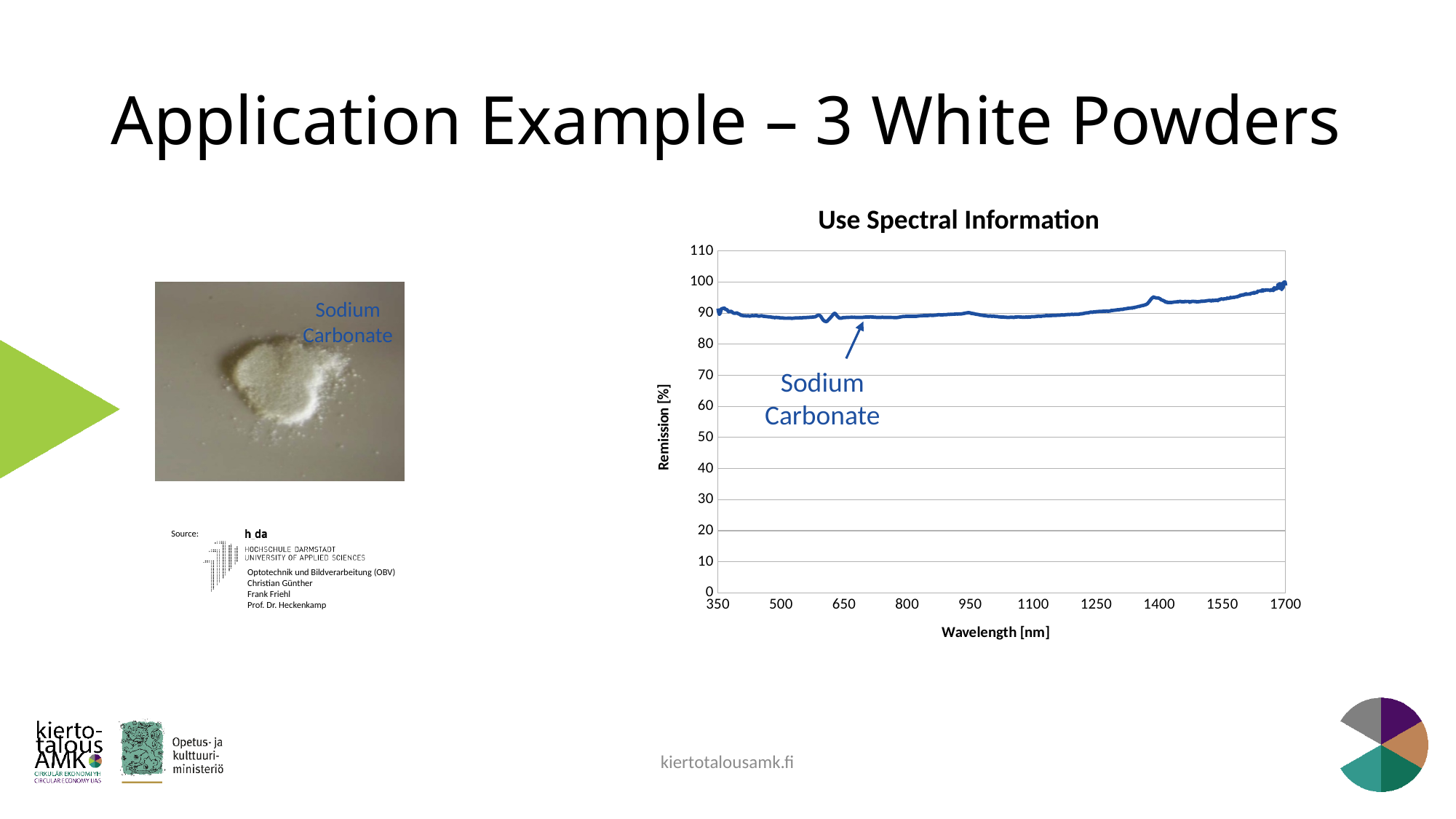
What is the highest wavelength value shown on the x axis of the chart? 1700 Is the remission value for Sodium Carbonate at 1100 nm greater or less than 80? greater What is the highest value shown on the y axis of the chart? 110 Is the remission value for Sodium Carbonate at 500 nm greater or less than 100? less How many data series are plotted in the chart? 1 Does the remission of Sodium Carbonate overall rise or fall from 350 nm to 1700 nm? rise What is the title of the chart on the slide? Use Spectral Information Which wavelength has the higher remission for Sodium Carbonate, 1100 nm or 1700 nm? 1700 nm What kind of chart is shown under the title "Use Spectral Information"? line chart What is the label of the x axis of the chart? Wavelength [nm] Which substance does the plotted line in the chart represent? Sodium Carbonate Is the remission value for Sodium Carbonate at 1700 nm greater or less than 90? greater